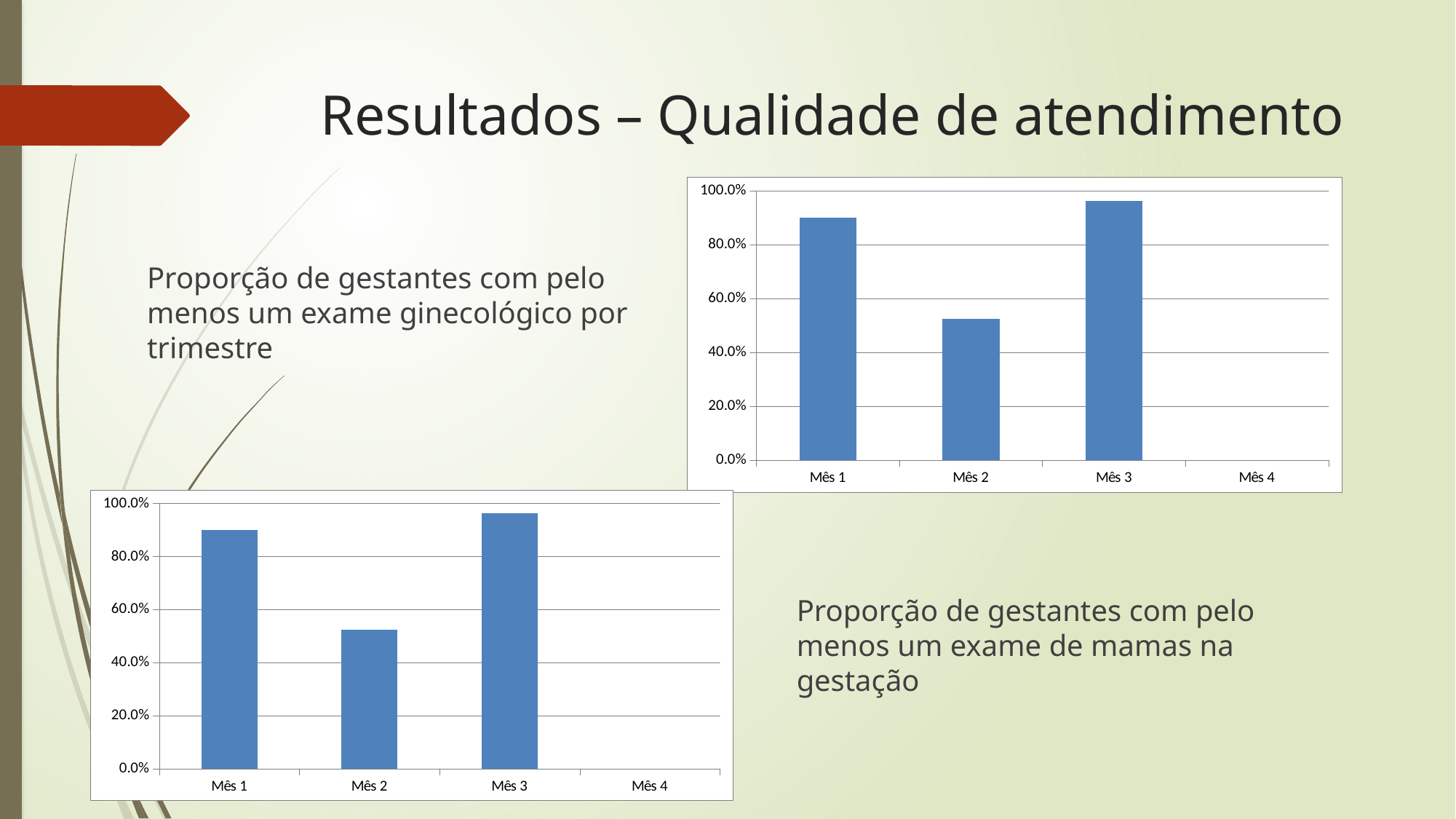
In the bottom-left chart, which month has the highest bar? Mês 3 In the top-right chart, which month has the highest bar? Mês 3 In the top-right chart, which is larger, the value for Mês 1 or the value for Mês 2? Mês 1 In the top-right chart, is the value for Mês 2 greater or less than 60.0%? less In the top-right chart, is the value for Mês 1 greater or less than 80.0%? greater What kind of chart is the bottom-left chart on the slide? bar chart How many month categories are shown on the x axis of the top-right chart? 4 In the top-right chart, which month has no bar plotted? Mês 4 What colour are the bars in the bottom-left chart? blue In the bottom-left chart, is the value for Mês 3 greater or less than 80.0%? greater In the bottom-left chart, which is larger, the value for Mês 3 or the value for Mês 2? Mês 3 What kind of chart is the top-right chart on the slide? bar chart